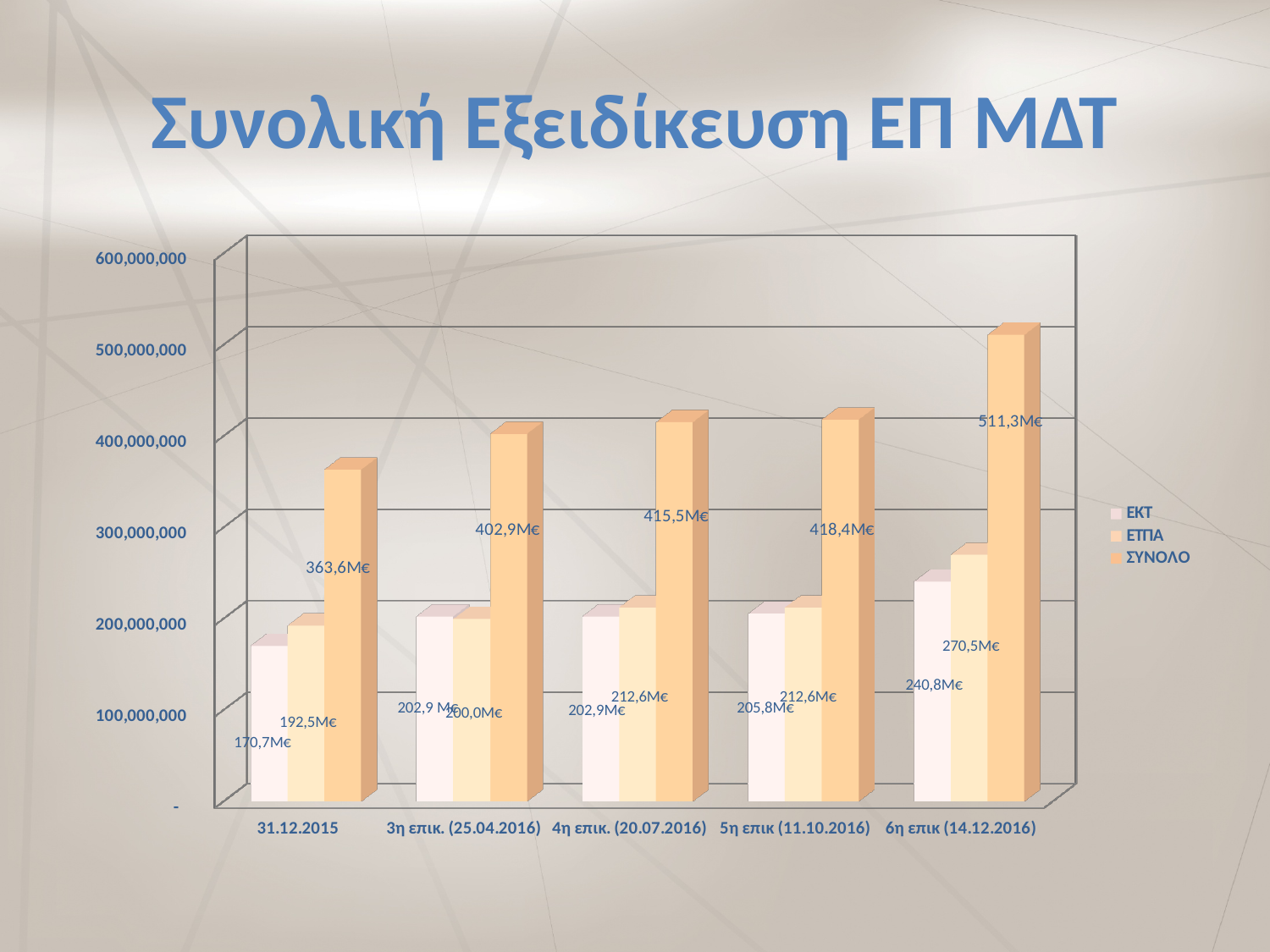
Which is larger for 31.12.2015: the ΕΚΤ value or the ΕΤΠΑ value? ΕΤΠΑ What is the ΕΚΤ value for 6η επικ (14.12.2016)? 240,8Μ€ Is the ΣΥΝΟΛΟ value for 6η επικ (14.12.2016) greater or less than 500,000,000? greater Does the ΣΥΝΟΛΟ value rise or fall from 31.12.2015 to 6η επικ (14.12.2016)? Rise Which category has the lowest ΕΚΤ value? 31.12.2015 How many categories are shown on the x axis? 5 What is the ΕΤΠΑ value for 4η επικ. (20.07.2016)? 212,6Μ€ What type of chart is shown on the slide? Bar chart What is the ΣΥΝΟΛΟ value for 31.12.2015? 363,6Μ€ Which category has the highest ΣΥΝΟΛΟ value? 6η επικ (14.12.2016) How many series does the legend list? 3 What is the title of the chart slide? Συνολική Εξειδίκευση ΕΠ ΜΔΤ